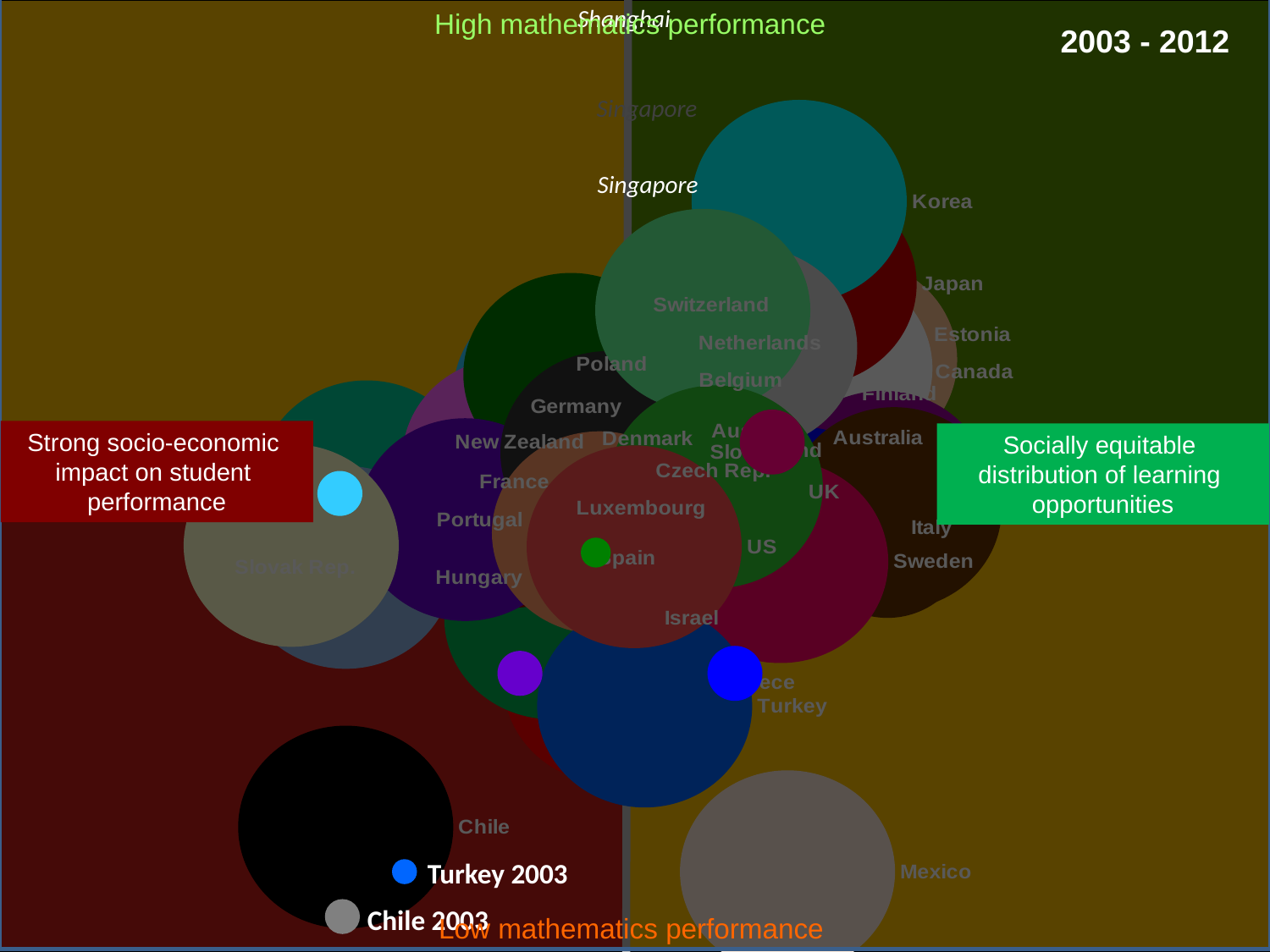
Which country's bubble is positioned highest on the chart? Korea What year range is shown in the top right corner of the chart? 2003 - 2012 Is the Chile bubble to the left or to the right of the vertical dividing line? left Which bubble is positioned higher on the chart, Korea or Mexico? Korea Which bubble is positioned further to the right on the chart, Chile or Mexico? Mexico Which country's bubble is positioned lowest on the chart? Mexico What kind of chart is shown on the slide? bubble chart